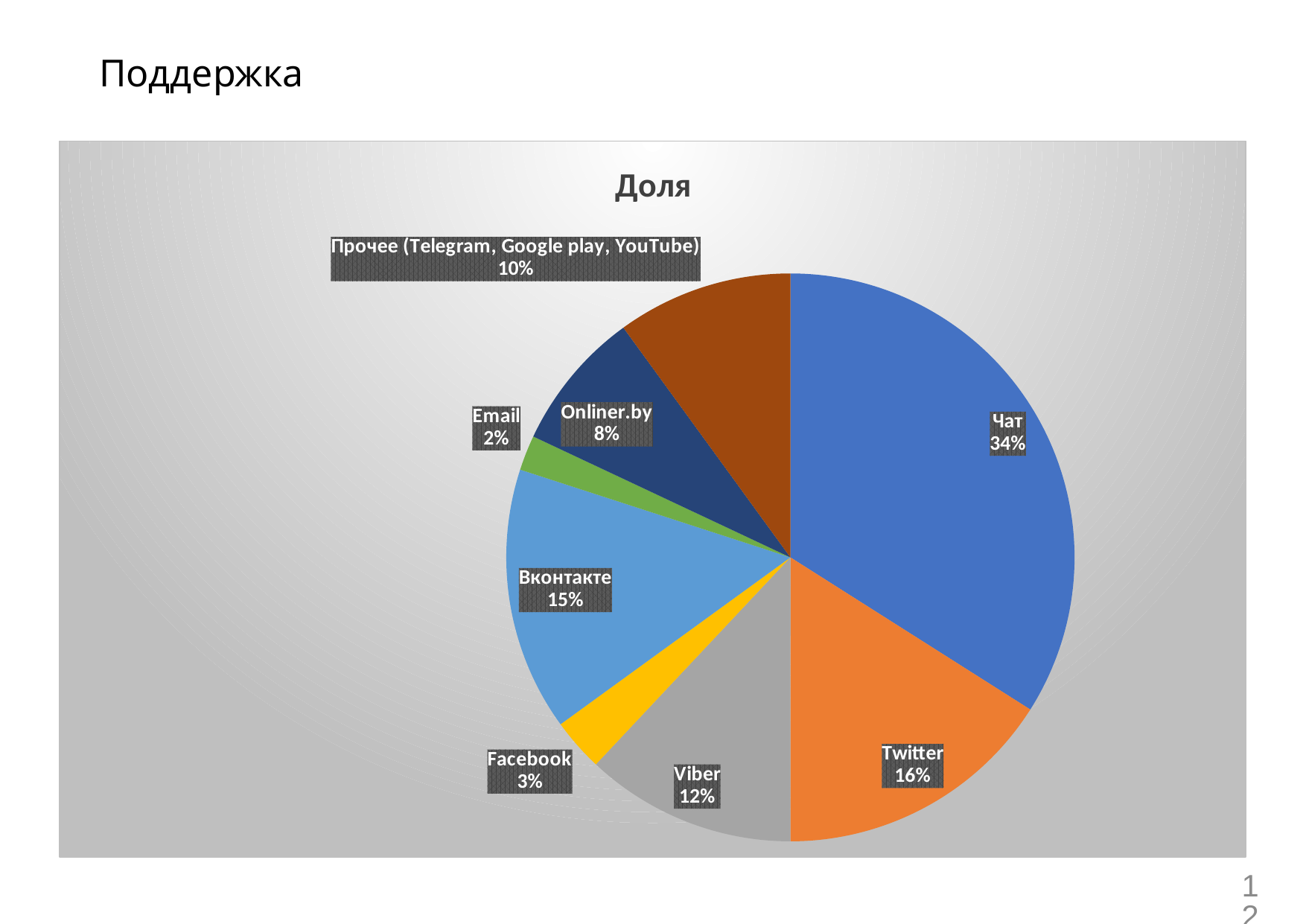
Which has a larger share, Viber or Вконтакте? Вконтакте What share does Twitter have in the pie chart? 16% How many categories are shown in the pie chart? 8 What is the title of the chart? Доля Which category has the smallest share of the pie? Email What share does Прочее (Telegram, Google play, YouTube) have in the pie chart? 10% Which category has the largest share of the pie? Чат What share does Чат have in the pie chart? 34% What share does Вконтакте have in the pie chart? 15% What is the difference between the shares of Чат and Twitter? 18% What kind of chart is shown on the slide? pie chart What share does Onliner.by have in the pie chart? 8%